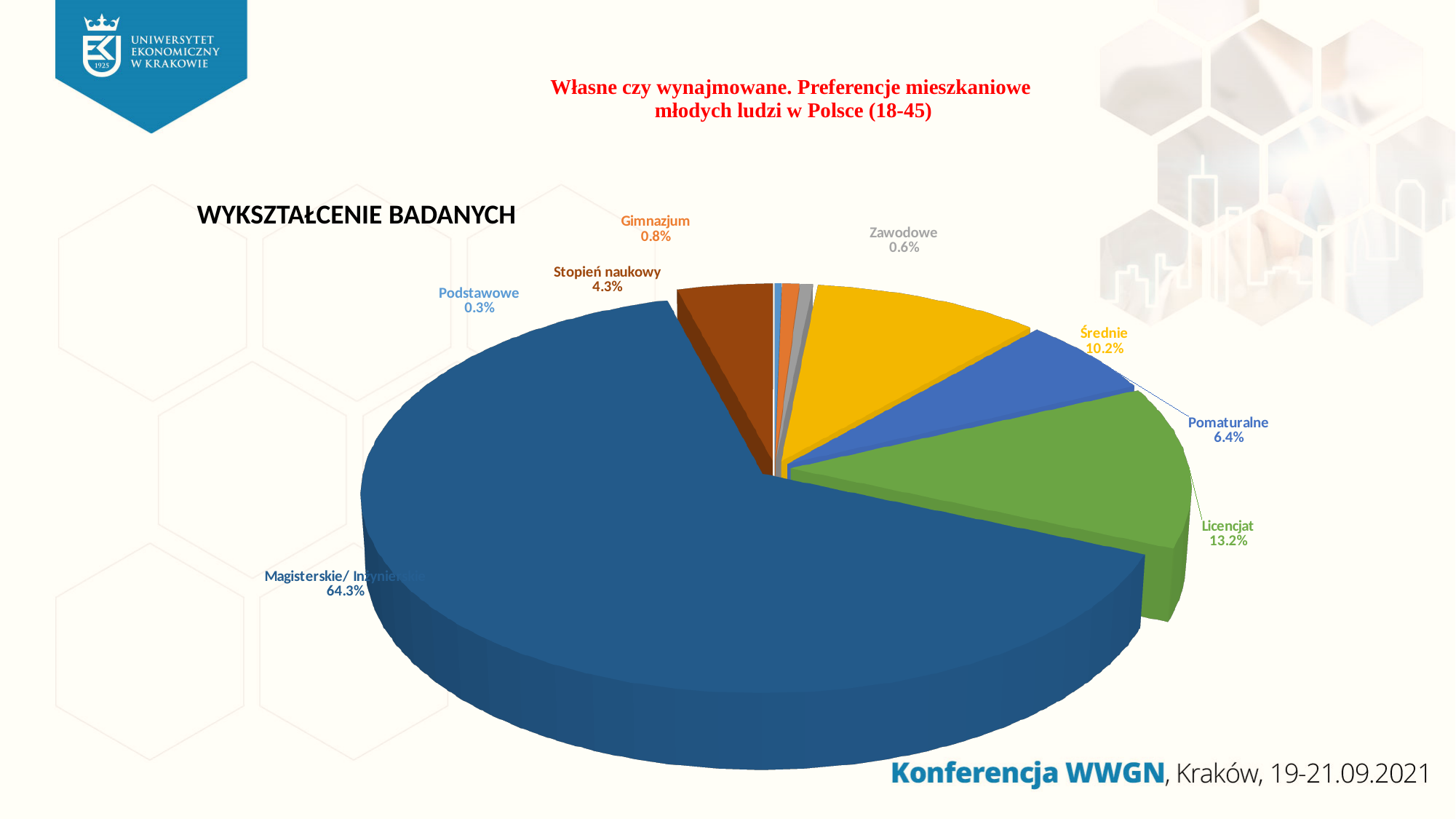
What share of the pie does Magisterskie/ Inżynierskie have? 64.3% What is the value shown for Stopień naukowy? 4.3% What is the value shown for Licencjat? 13.2% Which is larger, the value for Średnie or the value for Pomaturalne? Średnie What is the value shown for Średnie? 10.2% What is the title of the chart? WYKSZTAŁCENIE BADANYCH How many categories are shown in the pie chart? 8 Which category has the largest slice of the pie? Magisterskie/ Inżynierskie What is the difference between the values for Gimnazjum and Zawodowe? 0.2% Which category has the smallest slice of the pie? Podstawowe What type of chart is shown on the slide? Pie chart What is the difference between the values for Licencjat and Pomaturalne? 6.8%